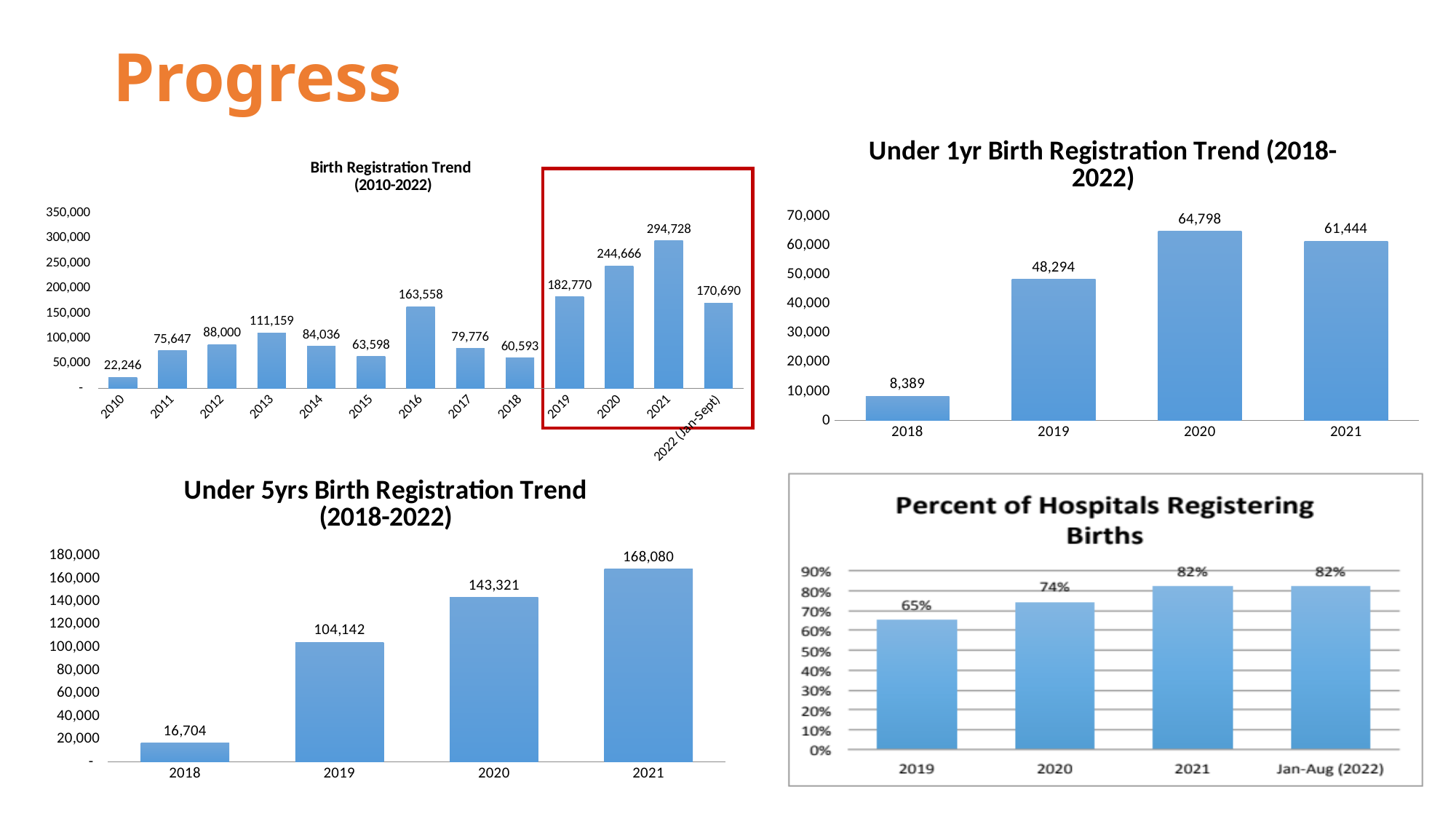
In the 'Birth Registration Trend (2010-2022)' chart, which year has the lowest value? 2010 In the 'Percent of Hospitals Registering Births' chart, what is the value for 2020? 74% In the 'Birth Registration Trend (2010-2022)' chart, what is the value for 2016? 163,558 In the 'Birth Registration Trend (2010-2022)' chart, which year has the highest value? 2021 In the 'Birth Registration Trend (2010-2022)' chart, how many bars are plotted? 13 In the 'Birth Registration Trend (2010-2022)' chart, what is the difference between the 2021 and 2020 values? 50,062 In the 'Under 5yrs Birth Registration Trend (2018-2022)' chart, what is the value for 2021? 168,080 In the 'Under 1yr Birth Registration Trend (2018-2022)' chart, which is larger, the value for 2020 or 2021? 2020 In the 'Under 5yrs Birth Registration Trend (2018-2022)' chart, what is the difference between the 2020 and 2019 values? 39,179 In the 'Under 1yr Birth Registration Trend (2018-2022)' chart, what is the value for 2019? 48,294 In the 'Under 5yrs Birth Registration Trend (2018-2022)' chart, do the values rise or fall from 2018 to 2021? rise What kind of chart is 'Percent of Hospitals Registering Births'? bar chart